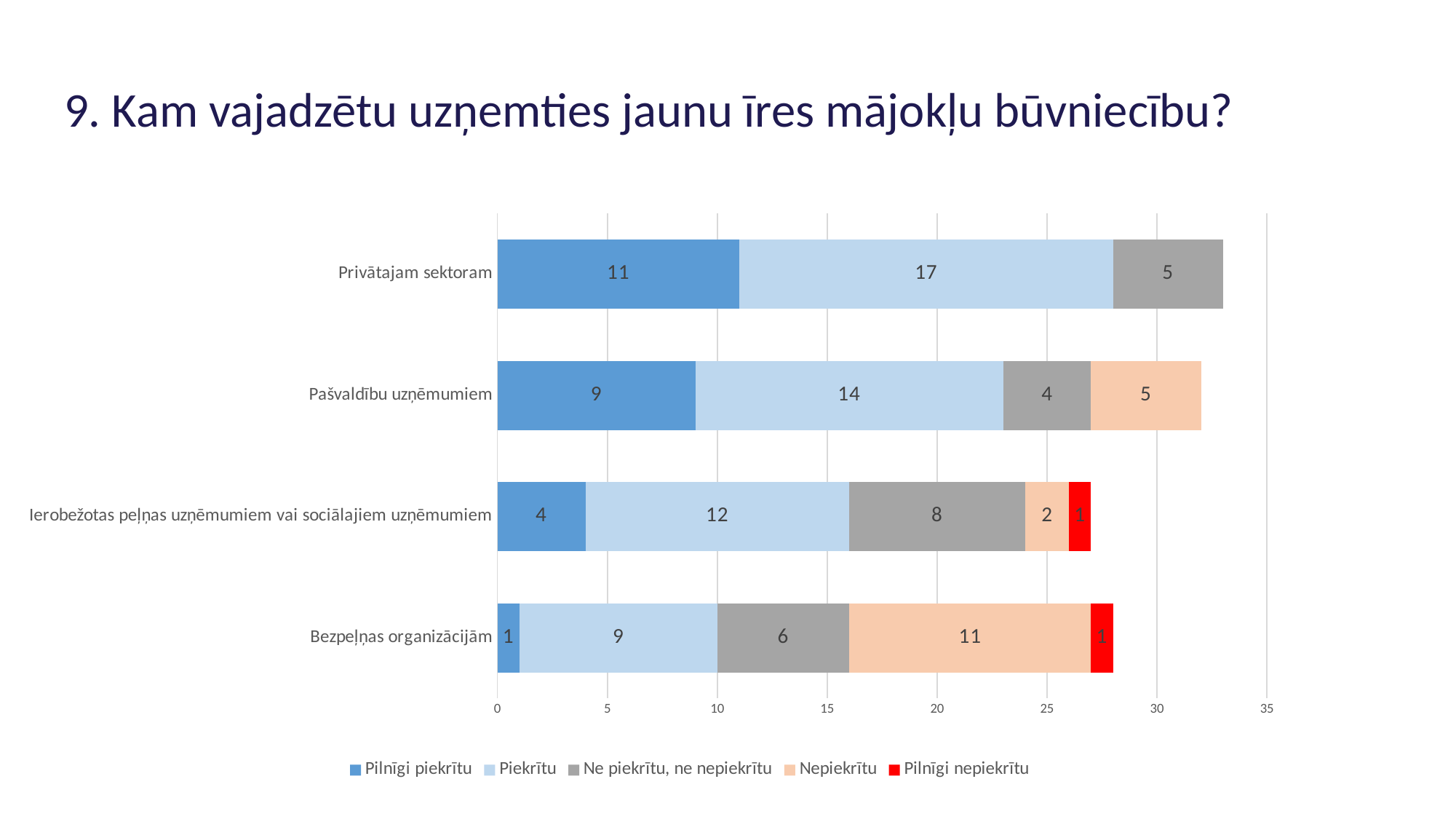
What is the 'Pilnīgi piekrītu' value for 'Privātajam sektoram'? 11 Which category has the highest 'Pilnīgi piekrītu' value? Privātajam sektoram What is the difference between the 'Piekrītu' values for 'Privātajam sektoram' and 'Pašvaldību uzņēmumiem'? 3 What is the 'Nepiekrītu' value for 'Bezpeļņas organizācijām'? 11 How many series does the legend list? 5 Which category has the lowest 'Piekrītu' value? Bezpeļņas organizācijām What is the 'Ne piekrītu, ne nepiekrītu' value for 'Ierobežotas peļņas uzņēmumiem vai sociālajiem uzņēmumiem'? 8 What is the 'Piekrītu' value for 'Pašvaldību uzņēmumiem'? 14 What is the total of the stacked bar for 'Pašvaldību uzņēmumiem'? 32 How many categories are plotted on the chart? 4 Which is larger: the 'Nepiekrītu' value for 'Pašvaldību uzņēmumiem' or for 'Bezpeļņas organizācijām'? Bezpeļņas organizācijām What kind of chart is shown on the slide? stacked bar chart